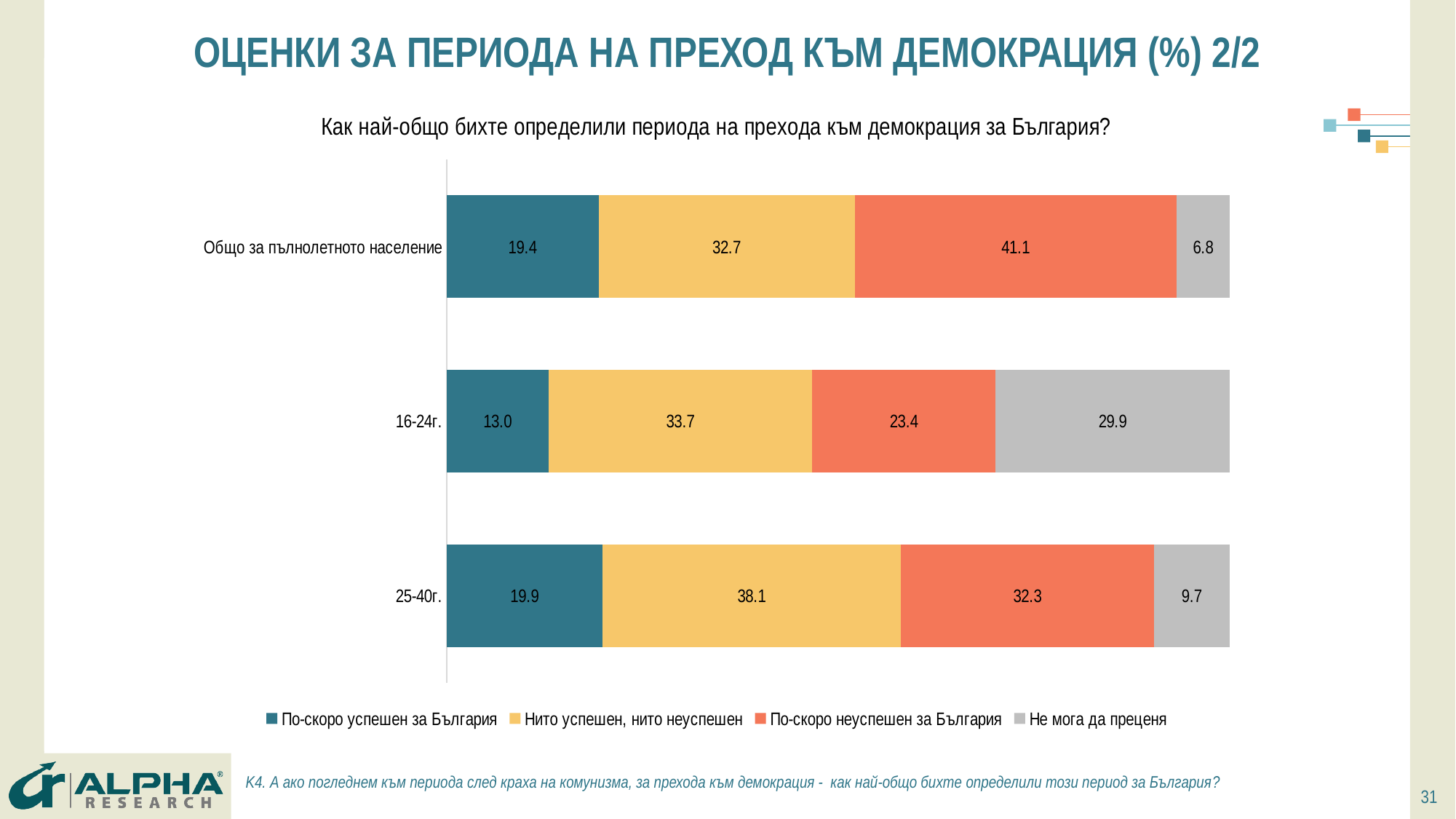
What is the value for "Не мога да преценя" in the "16-24г." bar? 29.9 Which category has the highest value for "Не мога да преценя"? 16-24г. What is the value for "По-скоро неуспешен за България" in the "Общо за пълнолетното население" bar? 41.1 Which category has the lowest value for "По-скоро успешен за България"? 16-24г. What is the value for "Нито успешен, нито неуспешен" in the "25-40г." bar? 38.1 What is the difference between the "По-скоро неуспешен за България" values for "Общо за пълнолетното население" and "16-24г."? 17.7 How many categories (bars) are shown in the chart? 3 How many series does the legend list? 4 What kind of chart is shown on the slide? Stacked bar chart What is the total of the stacked bar for "25-40г."? 100.0 Which is larger: "Нито успешен, нито неуспешен" for "25-40г." or for "Общо за пълнолетното население"? 25-40г. Which legend entry is shown in grey? Не мога да преценя